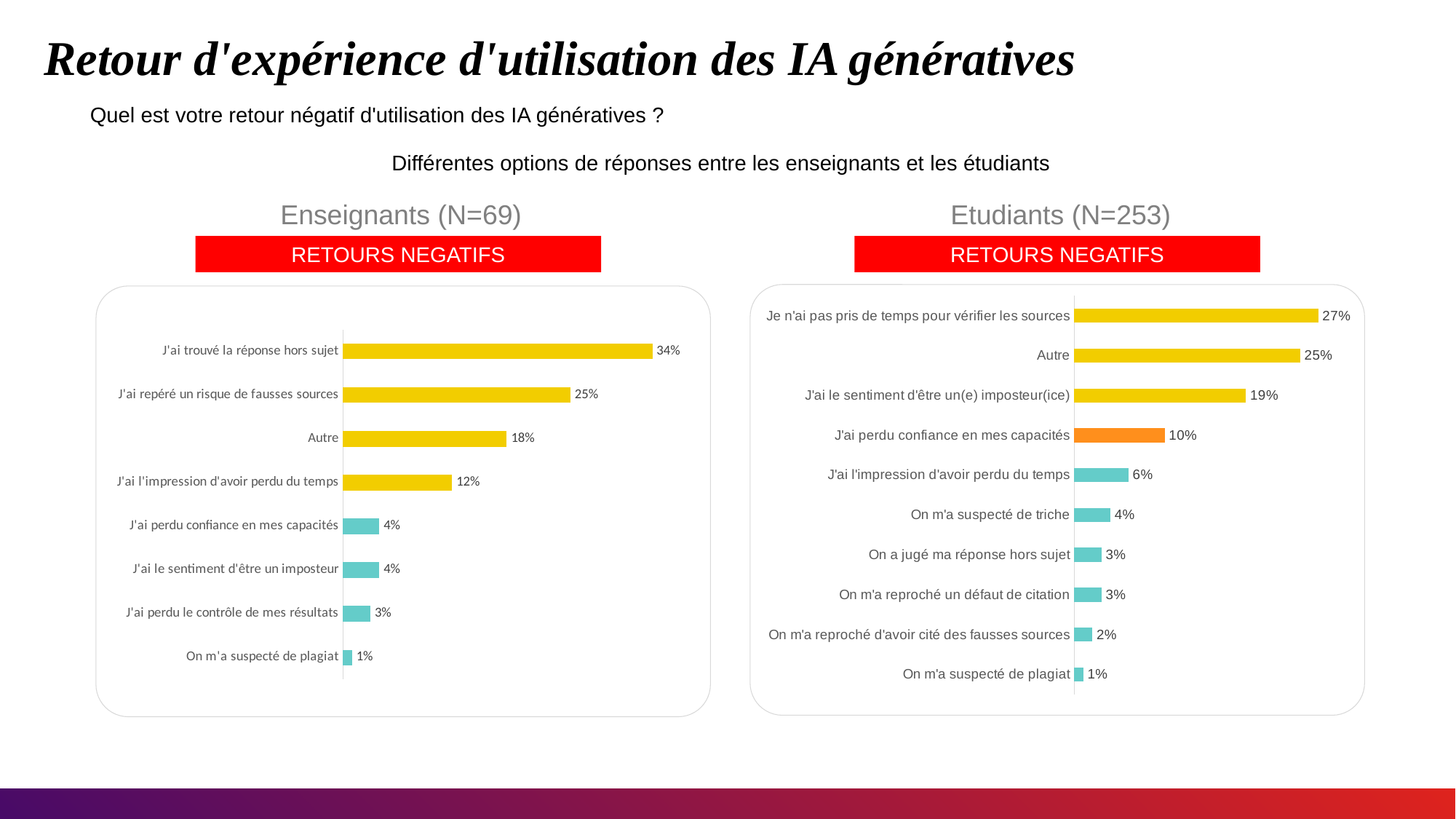
In the Etudiants (N=253) chart, what is the difference between "Autre" and "J'ai le sentiment d'être un(e) imposteur(ice)"? 6% In the Enseignants (N=69) chart, what is the value for "Autre"? 18% What type of chart is the Enseignants (N=69) chart? Bar chart In the Etudiants (N=253) chart, which category has the highest value? Je n'ai pas pris de temps pour vérifier les sources How many categories are shown in the Etudiants (N=253) chart? 10 In the Etudiants (N=253) chart, which is larger: "J'ai l'impression d'avoir perdu du temps" or "On m'a suspecté de triche"? J'ai l'impression d'avoir perdu du temps In the Etudiants (N=253) chart, what colour is the bar for "J'ai perdu confiance en mes capacités"? Orange In the Etudiants (N=253) chart, what is the value for "J'ai perdu confiance en mes capacités"? 10% In the Enseignants (N=69) chart, what is the value for "J'ai trouvé la réponse hors sujet"? 34% How many categories are shown in the Enseignants (N=69) chart? 8 In the Enseignants (N=69) chart, which category has the lowest value? On m'a suspecté de plagiat In the Enseignants (N=69) chart, what is the difference between "J'ai trouvé la réponse hors sujet" and "J'ai repéré un risque de fausses sources"? 9%